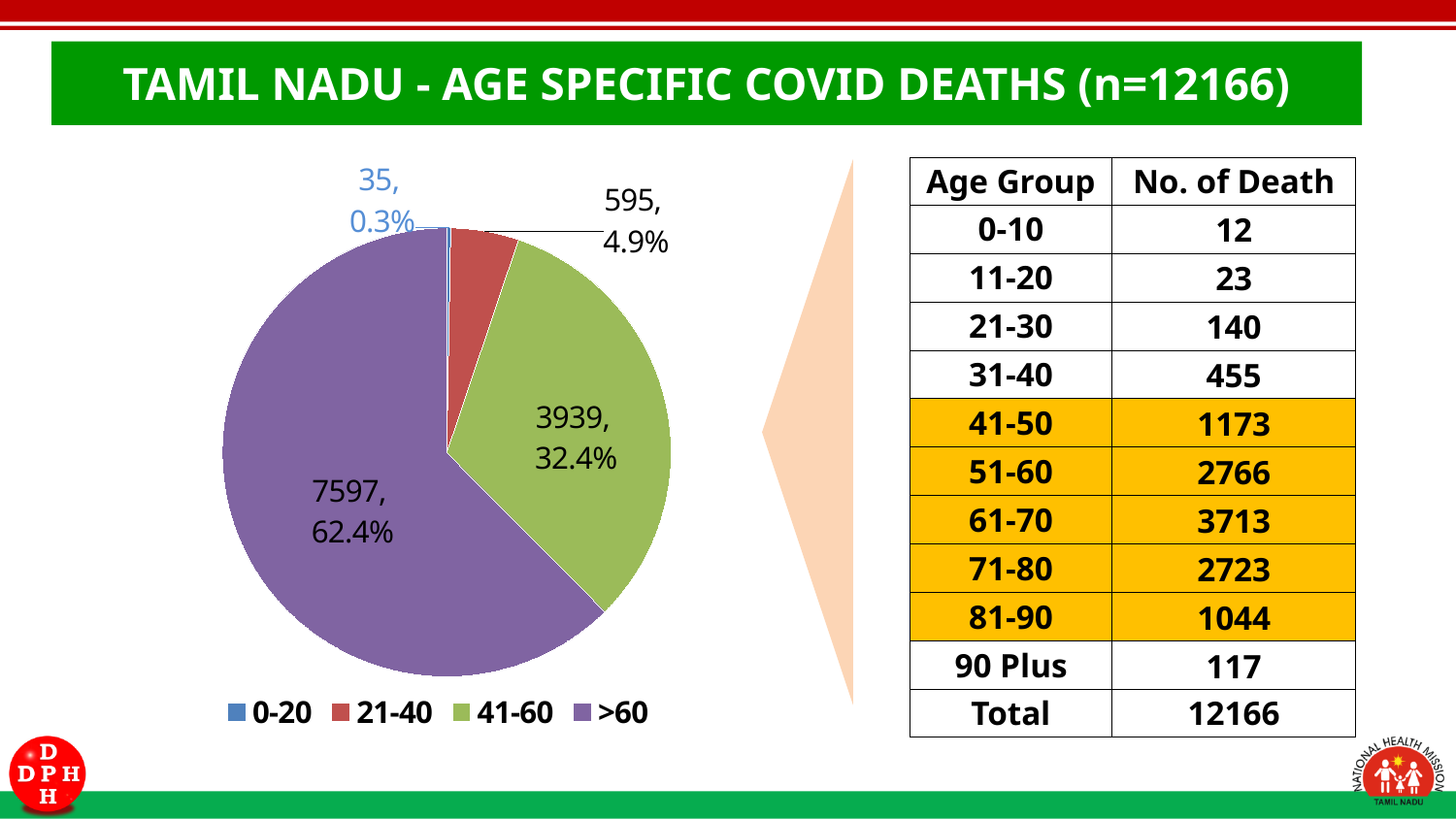
How many age groups are shown in the pie chart? 4 What is the title of the slide containing the pie chart? TAMIL NADU - AGE SPECIFIC COVID DEATHS (n=12166) What percentage share does the pie chart show for the 41-60 age group? 32.4% How many deaths does the pie chart show for the 21-40 age group? 595 Which age group has the largest slice in the pie chart? >60 Which age group has the smallest slice in the pie chart? 0-20 Which age group has more deaths in the pie chart, 21-40 or 41-60? 41-60 What colour is the >60 slice in the pie chart? purple What percentage share does the pie chart show for the 0-20 age group? 0.3% What is the difference in deaths between the >60 and 41-60 age groups in the pie chart? 3658 What kind of chart is shown on the slide? pie chart How many deaths does the pie chart show for the >60 age group? 7597